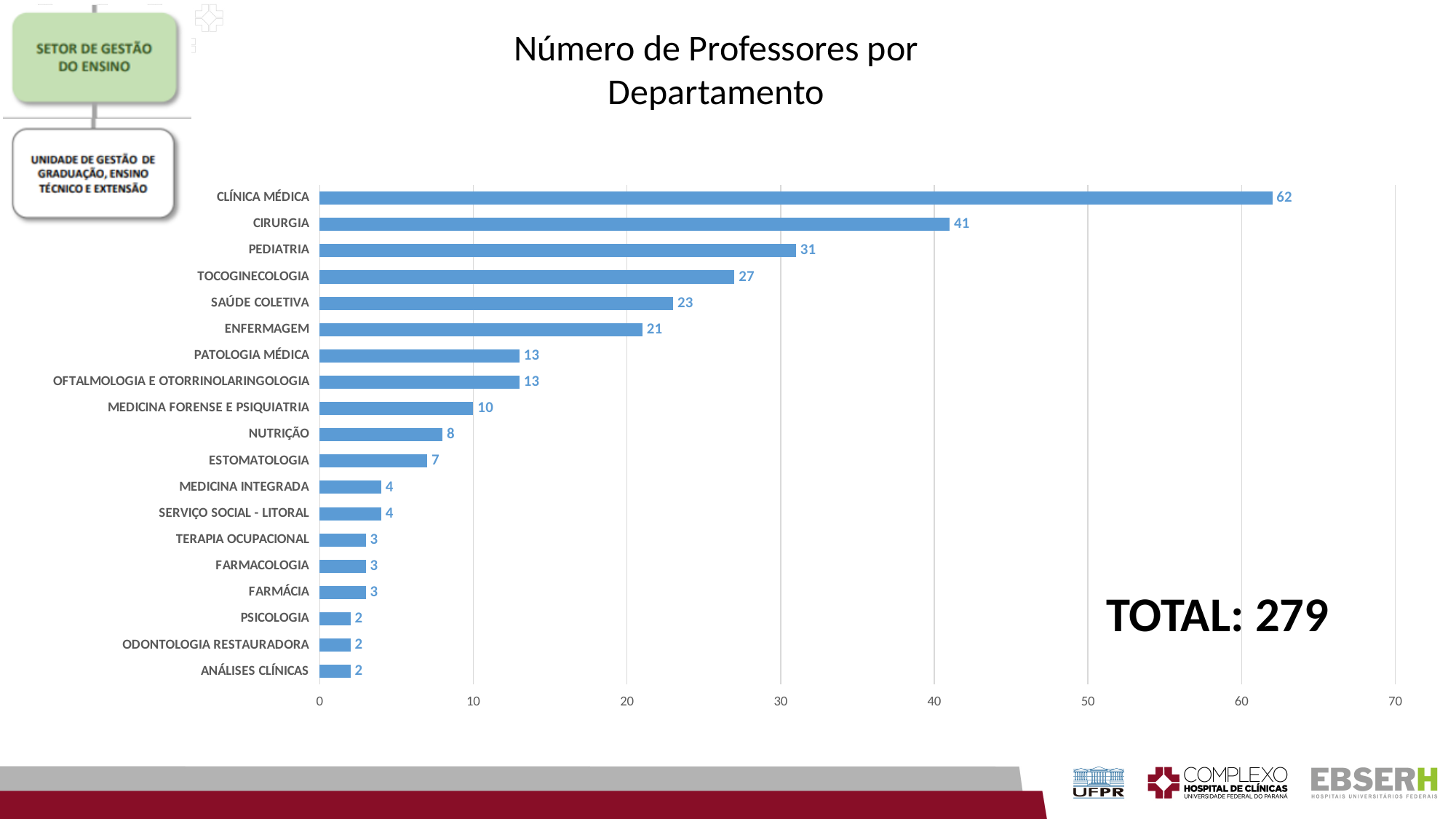
How many professors does the Clínica Médica department have? 62 What is the value shown for Medicina Forense e Psiquiatria? 10 What is the title of the chart? Número de Professores por Departamento What is the value shown for Enfermagem? 21 Which has more professors, Saúde Coletiva or Tocoginecologia? Tocoginecologia What type of chart is shown on the slide? Bar chart Which has more professors, Nutrição or Estomatologia? Nutrição Which department has the highest number of professors? Clínica Médica What total number of professors is stated on the slide? 279 What is the difference between the values for Clínica Médica and Cirurgia? 21 What is the difference between the values for Cirurgia and Pediatria? 10 How many departments are shown in the chart? 19